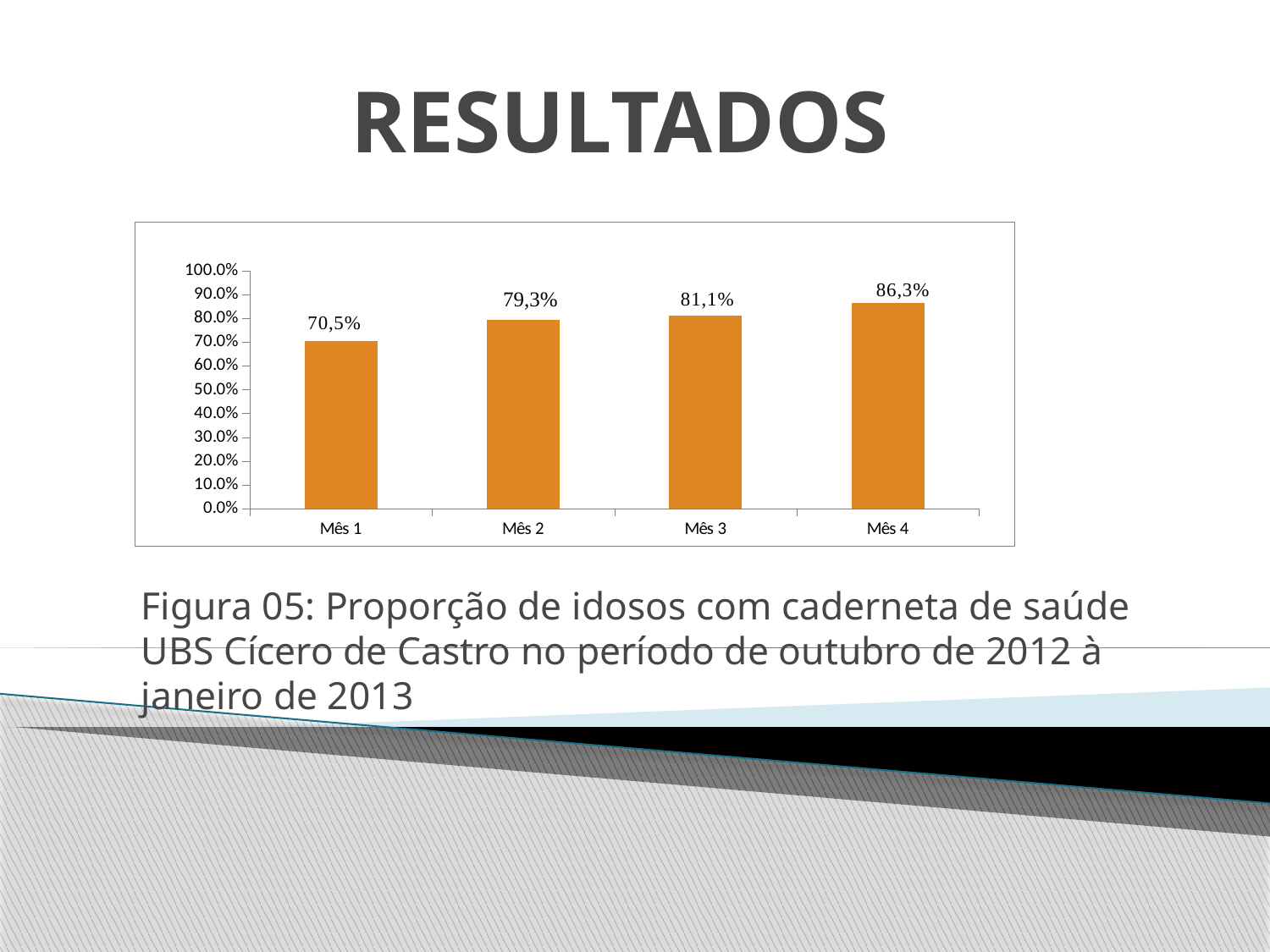
What is the value for Mês 1? 70,5% Which month has the highest value? Mês 4 How many months are shown on the chart? 4 Is the value for Mês 1 greater or less than 80.0%? less What is the difference between the values for Mês 4 and Mês 1? 15,8% Which is larger, the value for Mês 2 or the value for Mês 3? Mês 3 What is the value for Mês 4? 86,3% Do the values rise or fall from Mês 1 to Mês 4? rise What kind of chart is shown on the slide? bar chart What is the value for Mês 3? 81,1% What is the value for Mês 2? 79,3% Which month has the lowest value? Mês 1